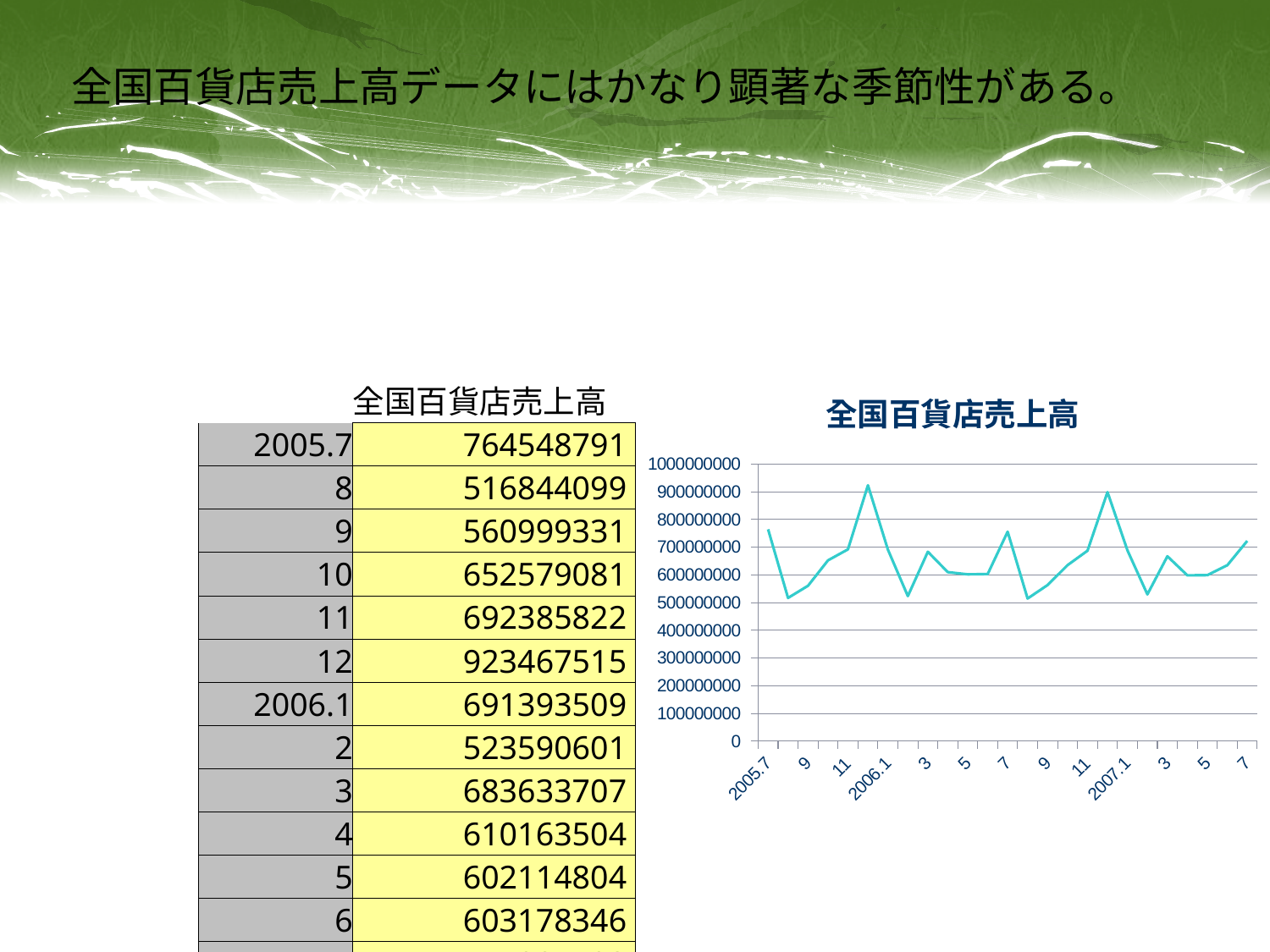
What is the difference between the values for 2005.12 and 2005.8 shown in the table? 406623416 What is the highest value shown on the chart's vertical axis? 1000000000 Which is larger, the value for 2005.7 or the value for 2005.8? 2005.7 Does the line rise or fall from 2005.7 to 2005.8? fall Is the value for 2005.12 on the chart greater or less than 900000000? greater Is the value for 2006.7 on the chart greater or less than 700000000? greater According to the table on the slide, what is the 全国百貨店売上高 value for 2005.12? 923467515 According to the table on the slide, what is the 全国百貨店売上高 value for 2006.1? 691393509 Is the value for 2006.12 on the chart greater or less than 800000000? greater What is the title of the chart? 全国百貨店売上高 What kind of chart is shown on the slide? line chart